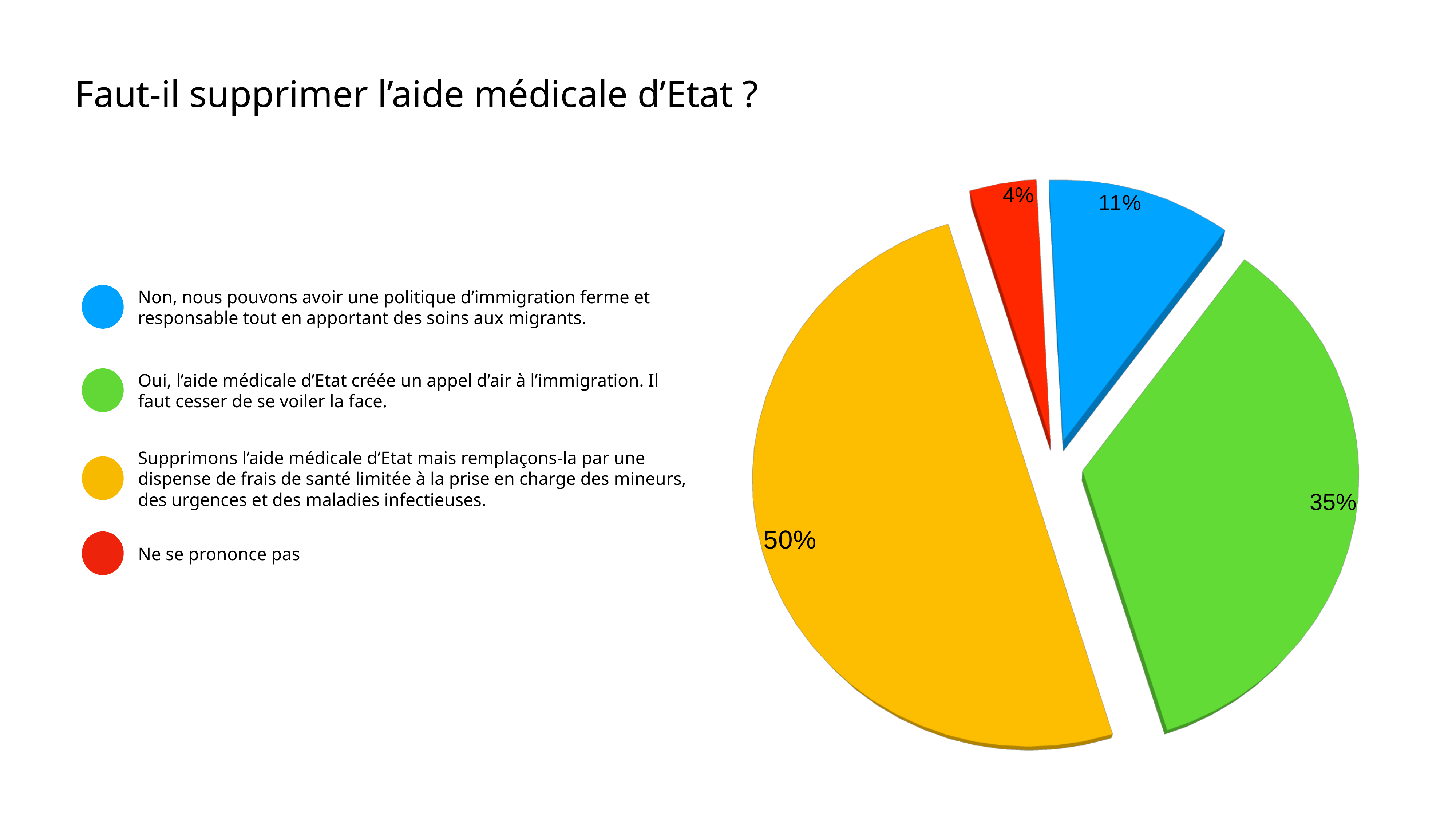
Which response has the smallest share of the pie? Ne se prononce pas What is the title of the slide containing the pie chart? Faut-il supprimer l'aide médicale d'Etat ? What share of the pie does the 'Ne se prononce pas' slice represent? 4% What percentage is shown for the slice 'Supprimons l'aide médicale d'Etat mais remplaçons-la par une dispense de frais de santé limitée à la prise en charge des mineurs, des urgences et des maladies infectieuses.'? 50% What percentage is shown for the slice 'Oui, l'aide médicale d'Etat créée un appel d'air à l'immigration. Il faut cesser de se voiler la face.'? 35% Which response has the largest share of the pie? Supprimons l'aide médicale d'Etat mais remplaçons-la par une dispense de frais de santé limitée à la prise en charge des mineurs, des urgences et des maladies infectieuses. What kind of chart is shown on the slide? pie chart What is the difference in percentage points between the 50% slice and the 35% slice? 15 What colour is the slice for 'Ne se prononce pas'? red Which is larger: the share for 'Ne se prononce pas' or the share for 'Non, nous pouvons avoir une politique d'immigration ferme et responsable tout en apportant des soins aux migrants.'? Non, nous pouvons avoir une politique d'immigration ferme et responsable tout en apportant des soins aux migrants. What percentage is shown for the slice 'Non, nous pouvons avoir une politique d'immigration ferme et responsable tout en apportant des soins aux migrants.'? 11% How many slices does the pie chart have? 4